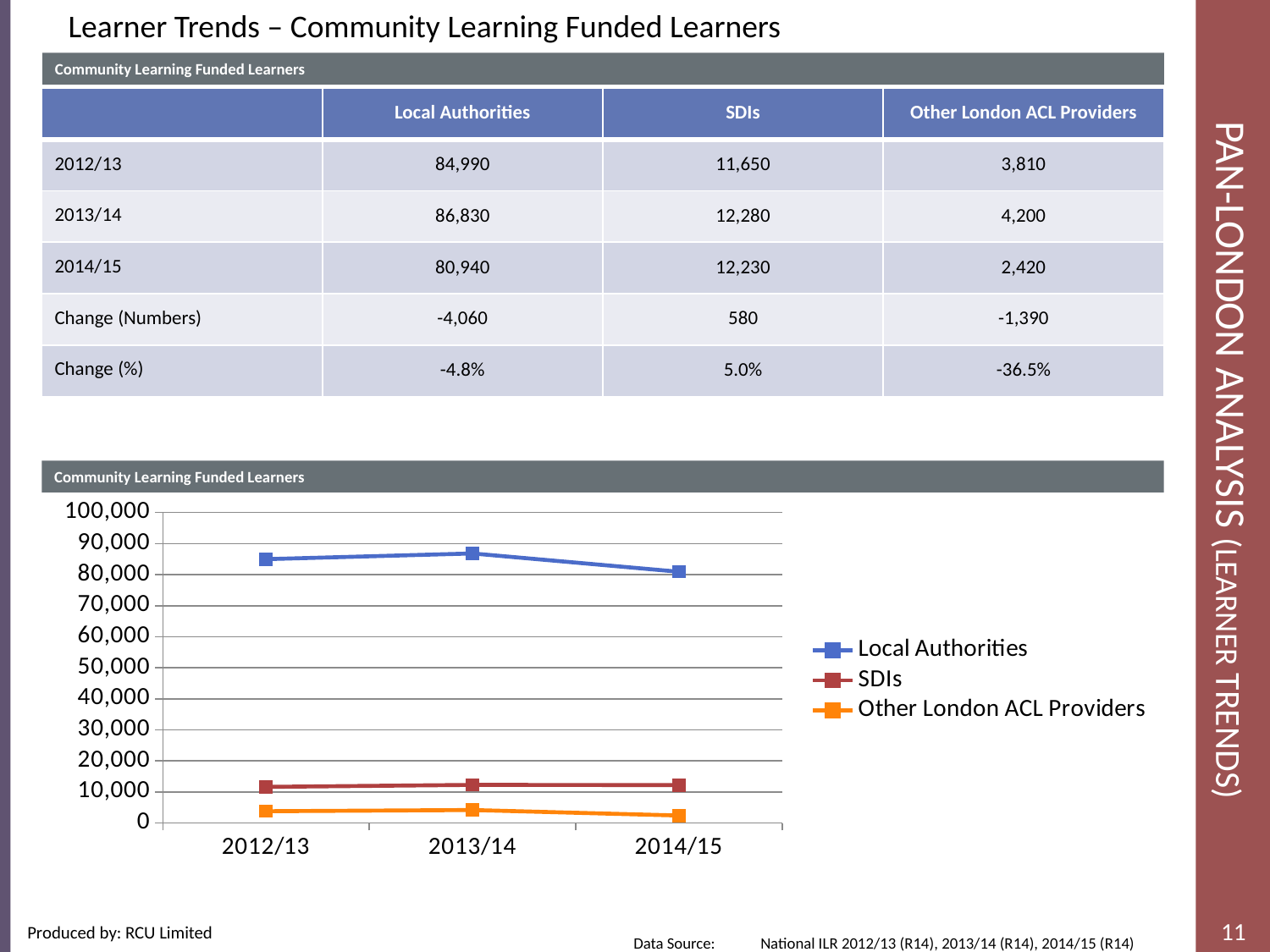
Is the value for Local Authorities in 2013/14 greater or less than 80,000? greater Is the value for SDIs in 2014/15 greater or less than 20,000? less Which is larger in 2012/13, the value for SDIs or the value for Other London ACL Providers? SDIs What kind of chart is shown on the slide? line chart Which series has the highest values in the chart? Local Authorities Which series has the lowest values in the chart? Other London ACL Providers Is the value for Other London ACL Providers in 2014/15 greater or less than 10,000? less According to the slide, what is the number of Local Authorities community learning funded learners in 2012/13? 84,990 What is the title of the chart? Community Learning Funded Learners Does the Local Authorities line rise or fall between 2013/14 and 2014/15? fall How many series does the chart legend list? 3 How many years are plotted along the x axis of the chart? 3